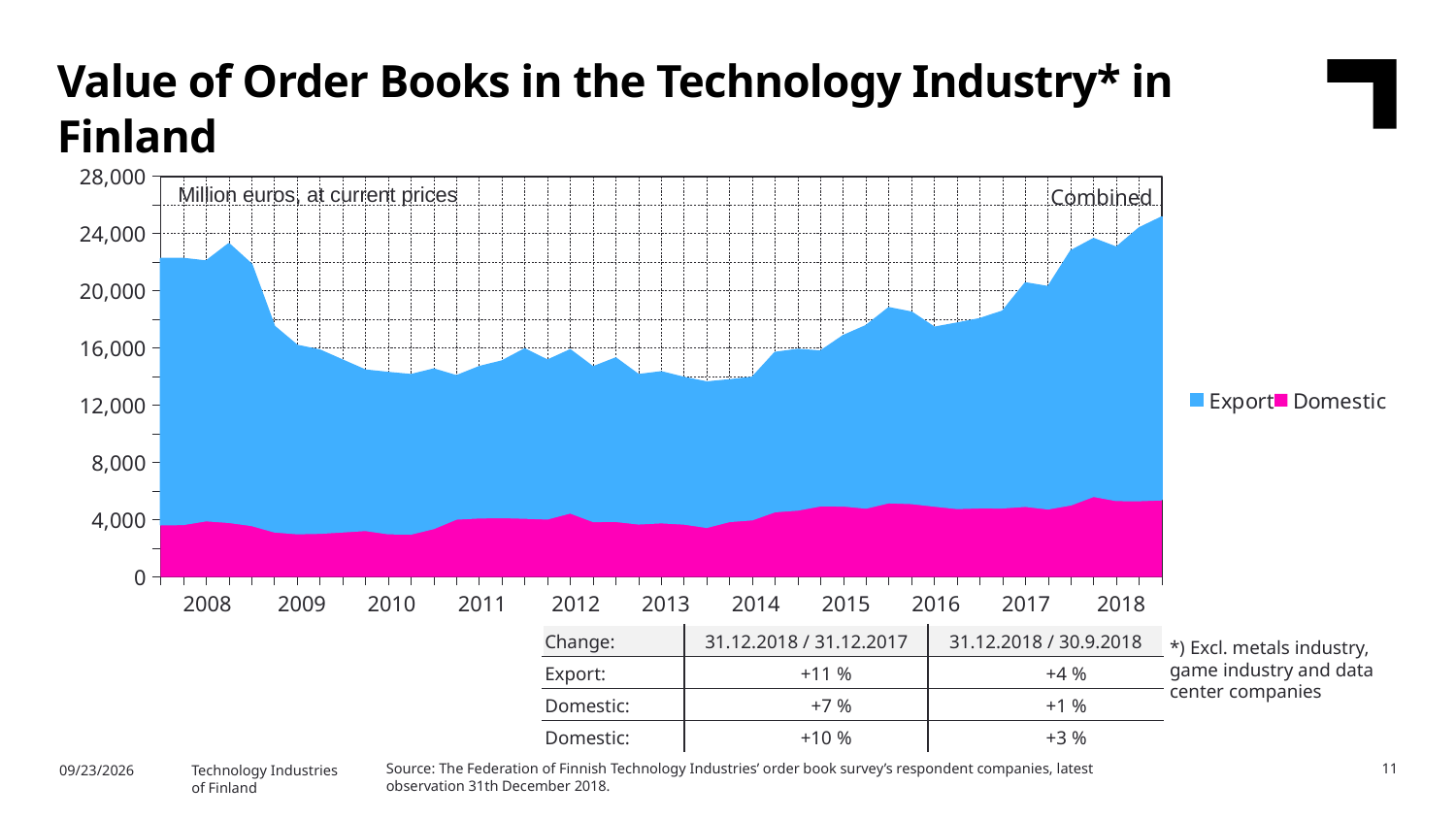
Does the combined value of order books rise or fall from 2014 to 2018? rise Which two series are shown in the legend? Export and Domestic Is the Domestic value in 2010 greater or less than 4,000? less Is the combined value of order books at the end of 2018 greater or less than 24,000? greater What type of chart is shown on the slide? Area chart Is the combined value of order books at the start of 2008 greater or less than 20,000? greater Which is larger, the combined value of order books in 2008 or in 2013? 2008 How many series does the legend list? 2 How many years are labeled on the x axis? 11 What unit is stated inside the chart area? Million euros, at current prices